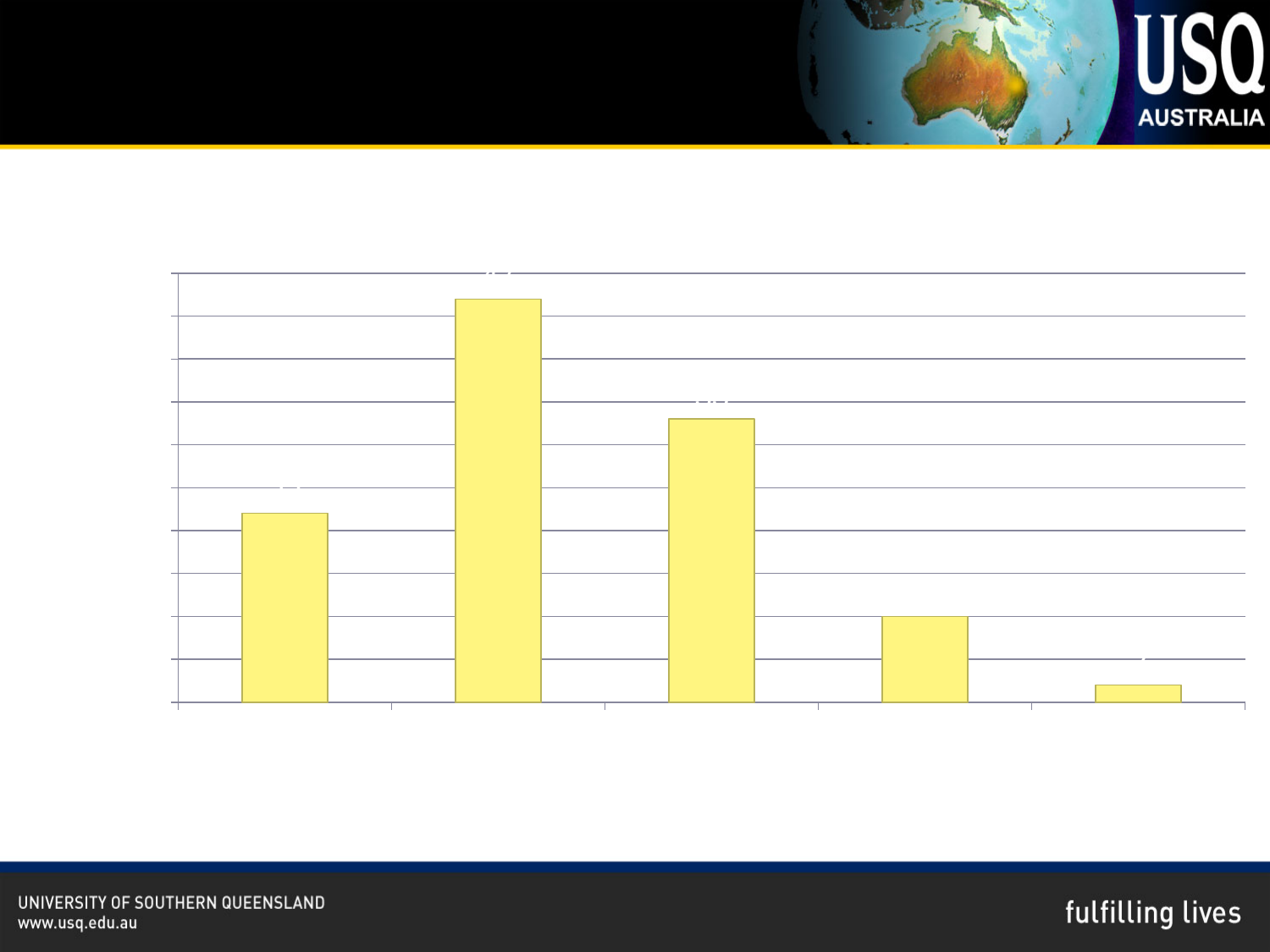
Which is taller, the first bar or the third bar? the third bar Which bar, counting from the left, is the tallest? the second bar What colour are the bars in the chart? yellow Which bar, counting from the left, is the shortest? the fifth bar Do the bar heights rise or fall from the second bar to the fifth bar? fall Do the bar heights rise or fall from the first bar to the second bar? rise Are the bars in the chart vertical or horizontal? vertical Which is taller, the first bar or the fourth bar? the first bar How many bars does the chart show? 5 What kind of chart is shown on the slide? bar chart Which is taller, the fourth bar or the fifth bar? the fourth bar